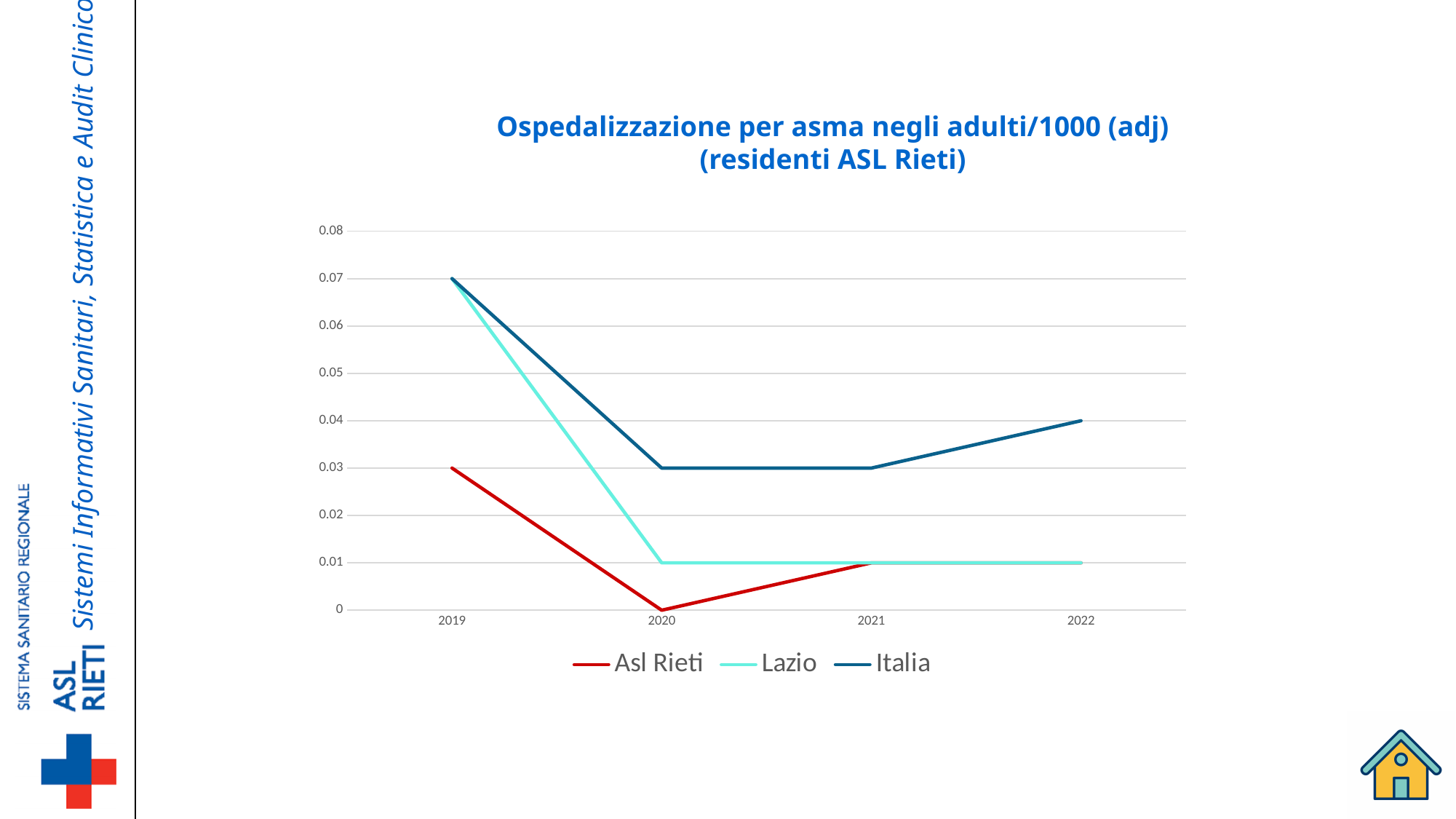
What kind of chart is shown on the slide? line chart How many series does the legend list? 3 What is the value for Italia in 2020? 0.03 Does the Lazio series rise or fall from 2019 to 2020? fall Which is larger in 2021, the value for Italia or the value for Lazio? Italia What is the value for Lazio in 2019? 0.07 What is the difference between the Italia and Asl Rieti values in 2019? 0.04 What is the value for Italia in 2022? 0.04 What is the value for Asl Rieti in 2020? 0 How many years are shown on the x axis? 4 Which series has the highest value in 2022? Italia In which year is the Asl Rieti value lowest? 2020